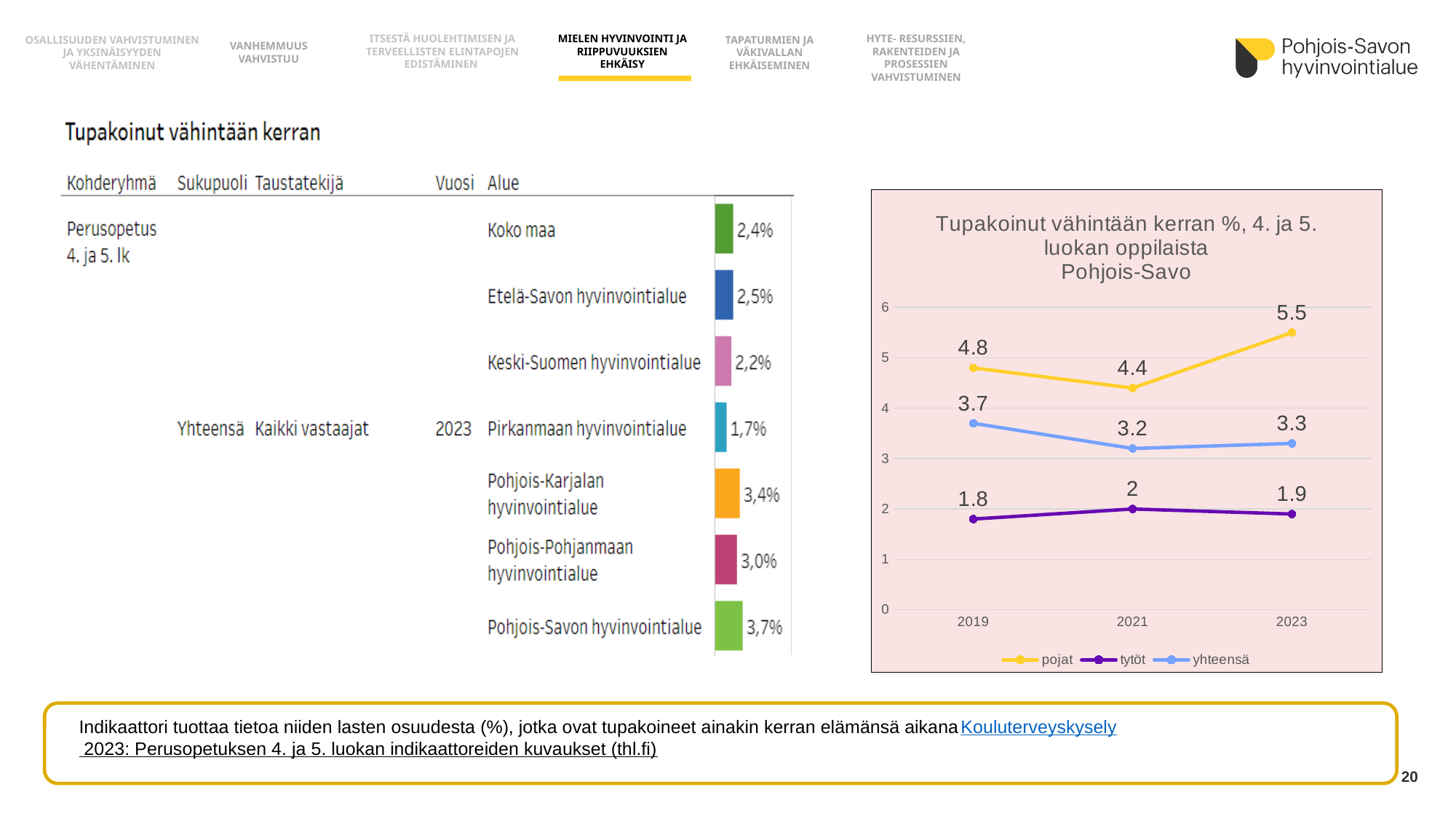
In the left bar chart, what is the value for Pohjois-Savon hyvinvointialue? 3,7% In the right line chart (Pohjois-Savo), what is the value for pojat in 2023? 5.5 In the left bar chart, which is larger: Pohjois-Karjalan hyvinvointialue or Pohjois-Pohjanmaan hyvinvointialue? Pohjois-Karjalan hyvinvointialue What kind of chart is the chart on the right of the slide? line chart In the right line chart (Pohjois-Savo), which series has the highest value in 2023? pojat In the left bar chart, how many regions are shown? 7 In the left bar chart, what is the difference between Pohjois-Savon hyvinvointialue and Koko maa? 1,3% In the right line chart (Pohjois-Savo), what is the difference between pojat and tytöt in 2019? 3 In the right line chart (Pohjois-Savo), what is the value for yhteensä in 2021? 3.2 In the right line chart (Pohjois-Savo), how many series does the legend list? 3 In the left bar chart, which region has the highest value? Pohjois-Savon hyvinvointialue In the left bar chart, which region has the lowest value? Pirkanmaan hyvinvointialue